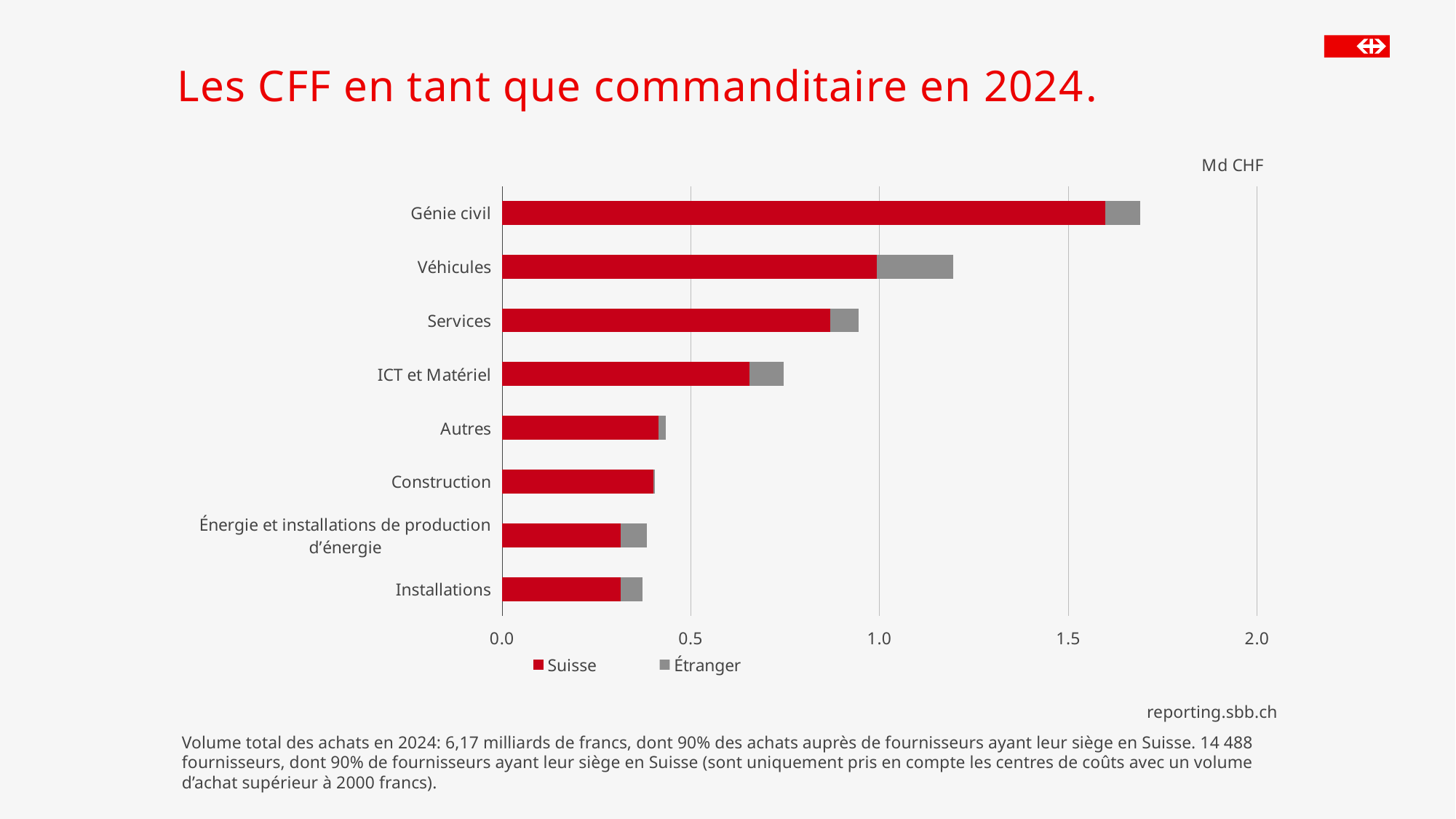
Is the total value for Véhicules greater or less than 1.0? greater Is the total value for Services greater or less than 1.0? less Which category has the highest total value? Génie civil Is the total value for ICT et Matériel greater or less than 0.5? greater How many categories are shown on the chart? 8 Which category has the largest Étranger segment? Véhicules How many series does the legend list? 2 What kind of chart is shown on the slide? bar chart Which has a larger total value, Véhicules or Services? Véhicules What unit is indicated above the chart? Md CHF